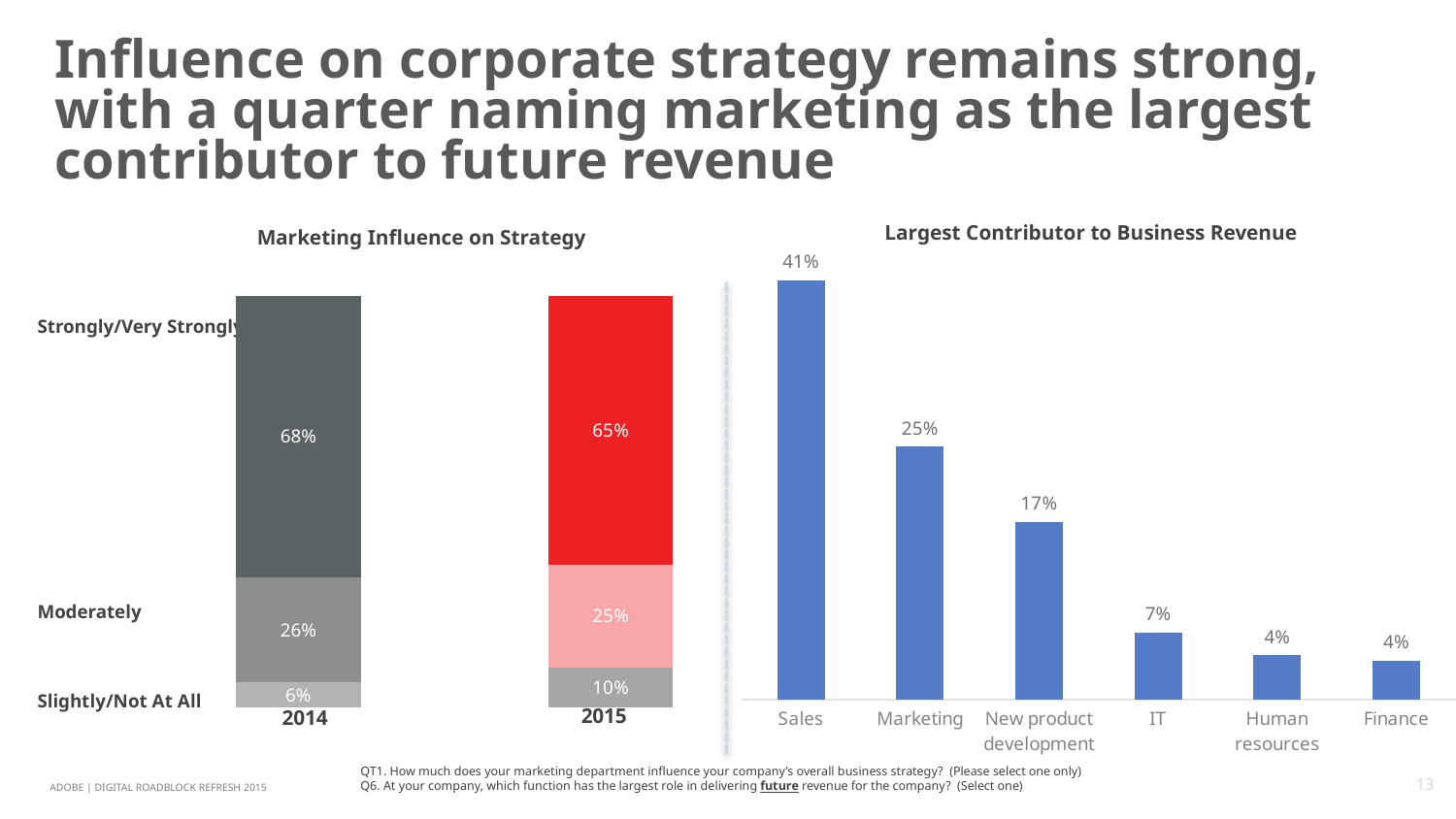
In the 'Marketing Influence on Strategy' chart, how many years are shown? 2 In the 'Marketing Influence on Strategy' chart, what is the Strongly/Very Strongly value for 2015? 65% In the 'Marketing Influence on Strategy' chart, by how many percentage points did the Strongly/Very Strongly share change from 2014 to 2015? 3 percentage points lower In the 'Marketing Influence on Strategy' chart, what is the total of the 2014 stacked bar? 100% In the 'Largest Contributor to Business Revenue' chart, which function has the highest value? Sales In the 'Largest Contributor to Business Revenue' chart, how many functions are shown? 6 In the 'Marketing Influence on Strategy' chart, what is the Slightly/Not At All value for 2015? 10% In the 'Largest Contributor to Business Revenue' chart, what is the value for Marketing? 25% In the 'Largest Contributor to Business Revenue' chart, what is the difference between Sales and Marketing? 16% What type of chart is the 'Largest Contributor to Business Revenue' chart? Bar chart In the 'Marketing Influence on Strategy' chart, what is the Moderately value for 2014? 26% In the 'Largest Contributor to Business Revenue' chart, which is larger, New product development or IT? New product development